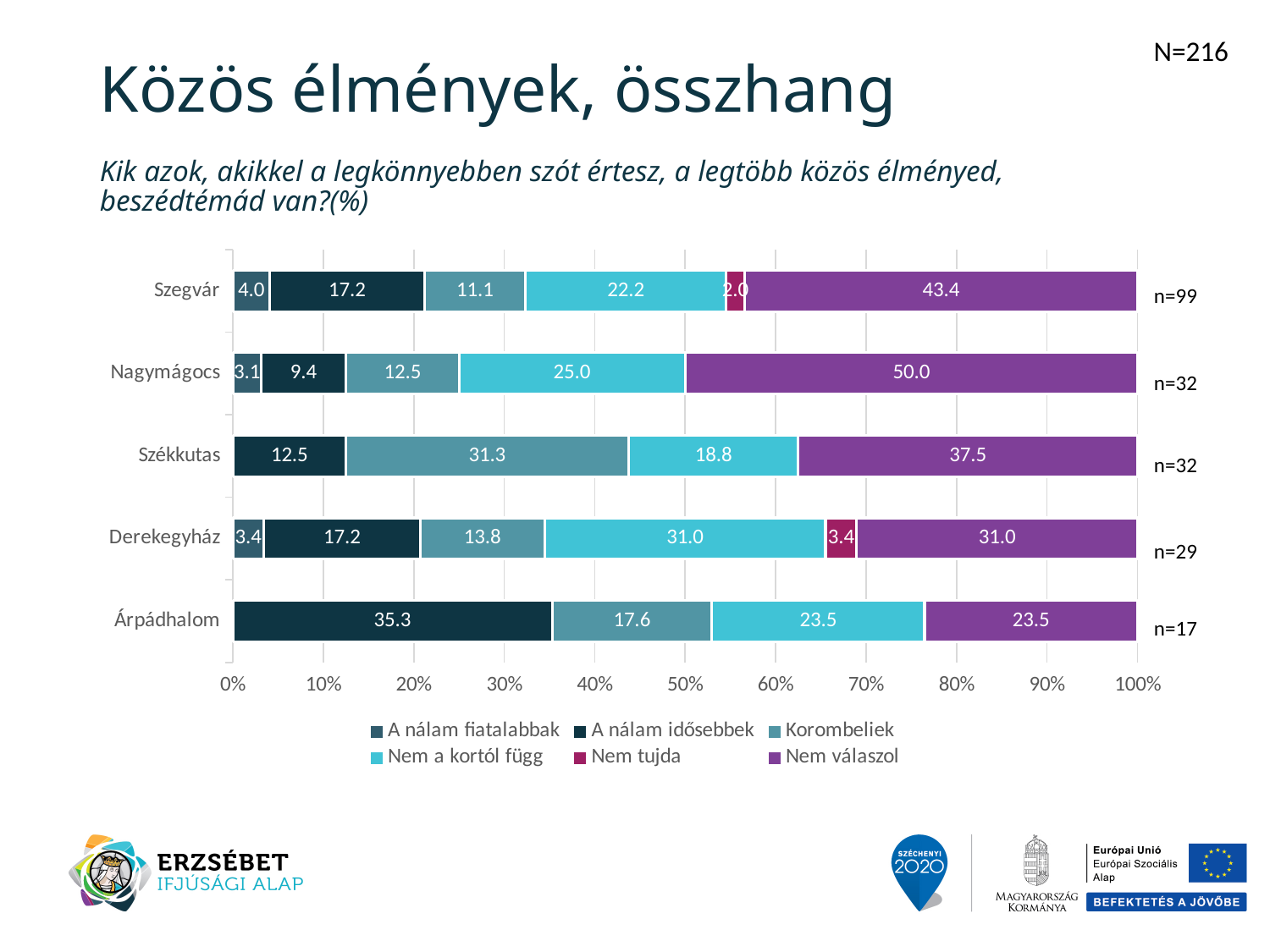
What kind of chart is shown on the slide? Stacked bar chart What sample size (n) is shown next to the Szegvár bar? n=99 What is the value of "Nem tudja" for Derekegyház? 3.4 For Derekegyház, which is larger: "Nem a kortól függ" or "Korombeliek"? Nem a kortól függ What is the value of "Nem válaszol" for Nagymágocs? 50.0 What is the value of "Korombeliek" for Székkutas? 31.3 What is the value of "A nálam idősebbek" for Árpádhalom? 35.3 How many series does the legend list? 6 Which category has the lowest value for "Nem válaszol"? Árpádhalom How many categories (settlements) are shown on the chart? 5 For Szegvár, what is the difference between "Nem válaszol" and "Nem a kortól függ"? 21.2 Which category has the highest value for "Nem válaszol"? Nagymágocs